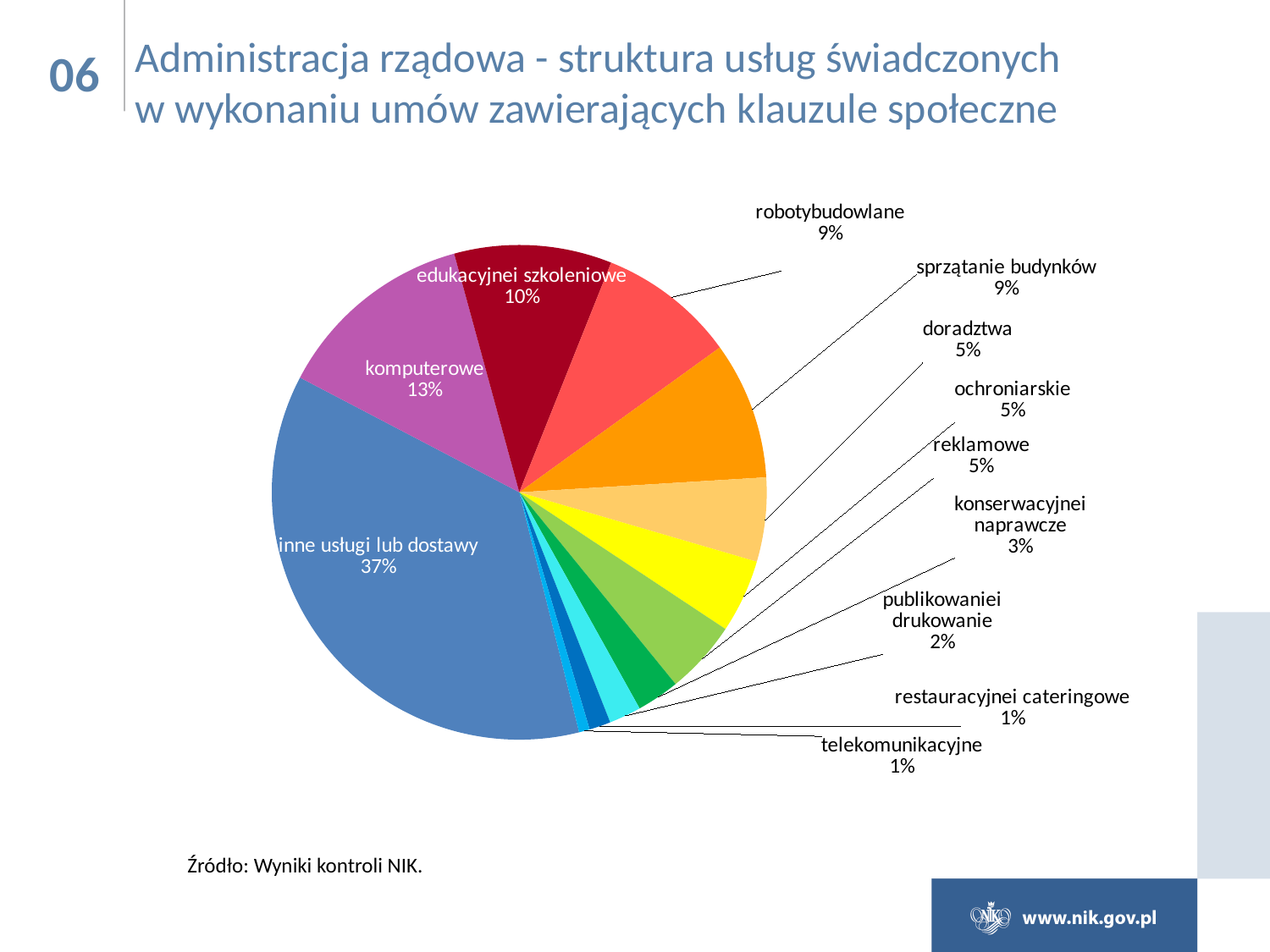
What kind of chart is shown on the slide? pie chart What is the difference in percentage points between 'inne usługi lub dostawy' and 'komputerowe'? 24 percentage points What percentage is shown for 'sprzątanie budynków'? 9% What percentage is shown for 'publikowanie i drukowanie'? 2% Which is larger, the share for 'komputerowe' or for 'roboty budowlane'? komputerowe What percentage is shown for 'edukacyjne i szkoleniowe'? 10% How many categories (slices) does the pie chart have? 12 What percentage is shown for 'komputerowe'? 13% What is the source given below the chart? Wyniki kontroli NIK. Which category has the largest share of the pie? inne usługi lub dostawy What share of the pie does 'inne usługi lub dostawy' have? 37% What percentage is shown for 'konserwacyjne i naprawcze'? 3%